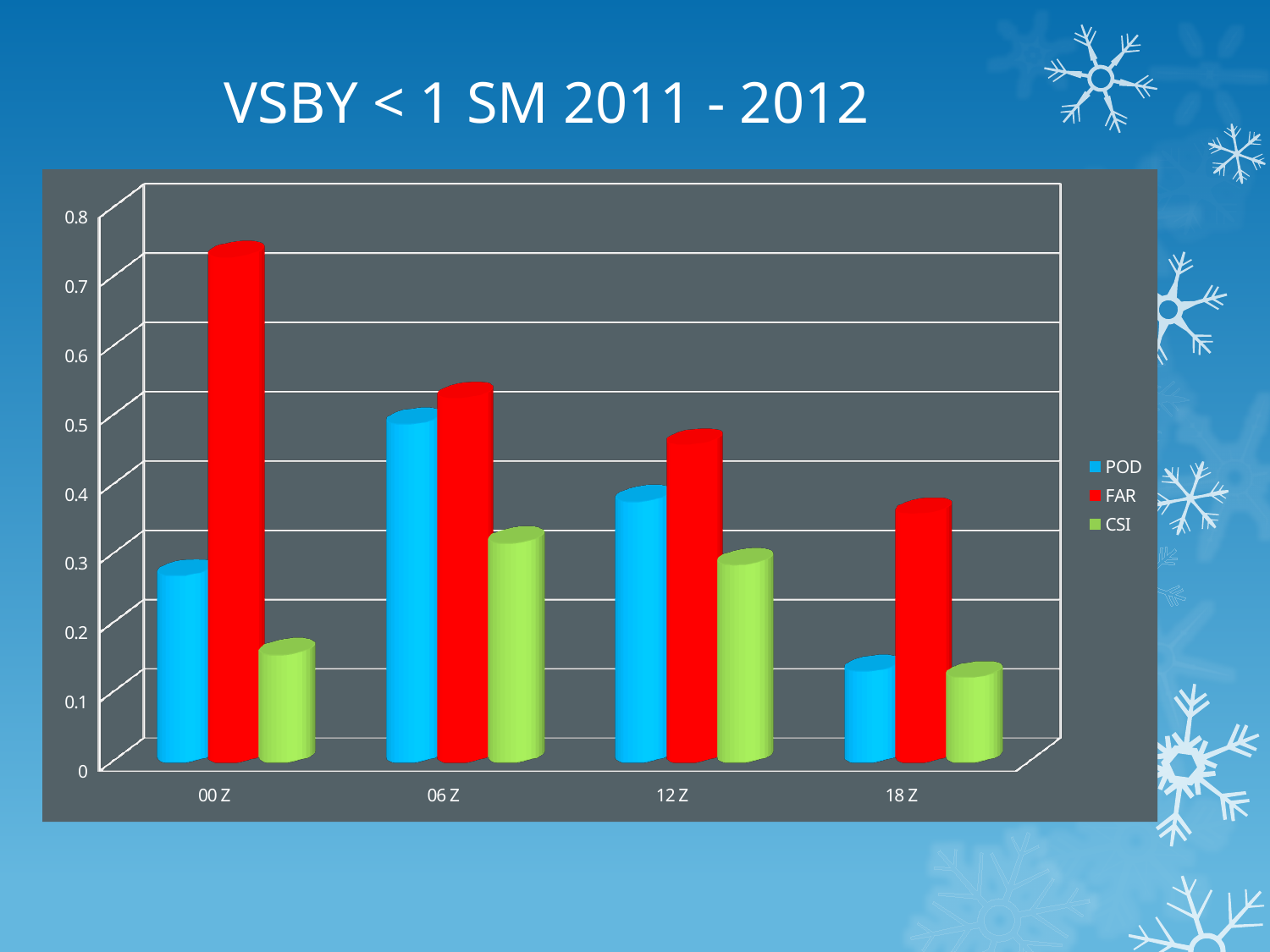
At which time is the FAR value lowest? 18 Z What kind of chart is shown on the slide? Bar chart At which time is the POD value lowest? 18 Z Which series are listed in the legend? POD, FAR, CSI What is the title of the chart? VSBY < 1 SM 2011 - 2012 At which time is the POD value highest? 06 Z How many series does the legend list? 3 How many categories are shown on the x axis? 4 At which time is the FAR value highest? 00 Z Is the FAR value at 00 Z greater or less than 0.6? greater Do the FAR values rise or fall from 00 Z to 18 Z? fall At 00 Z, which is larger, POD or FAR? FAR